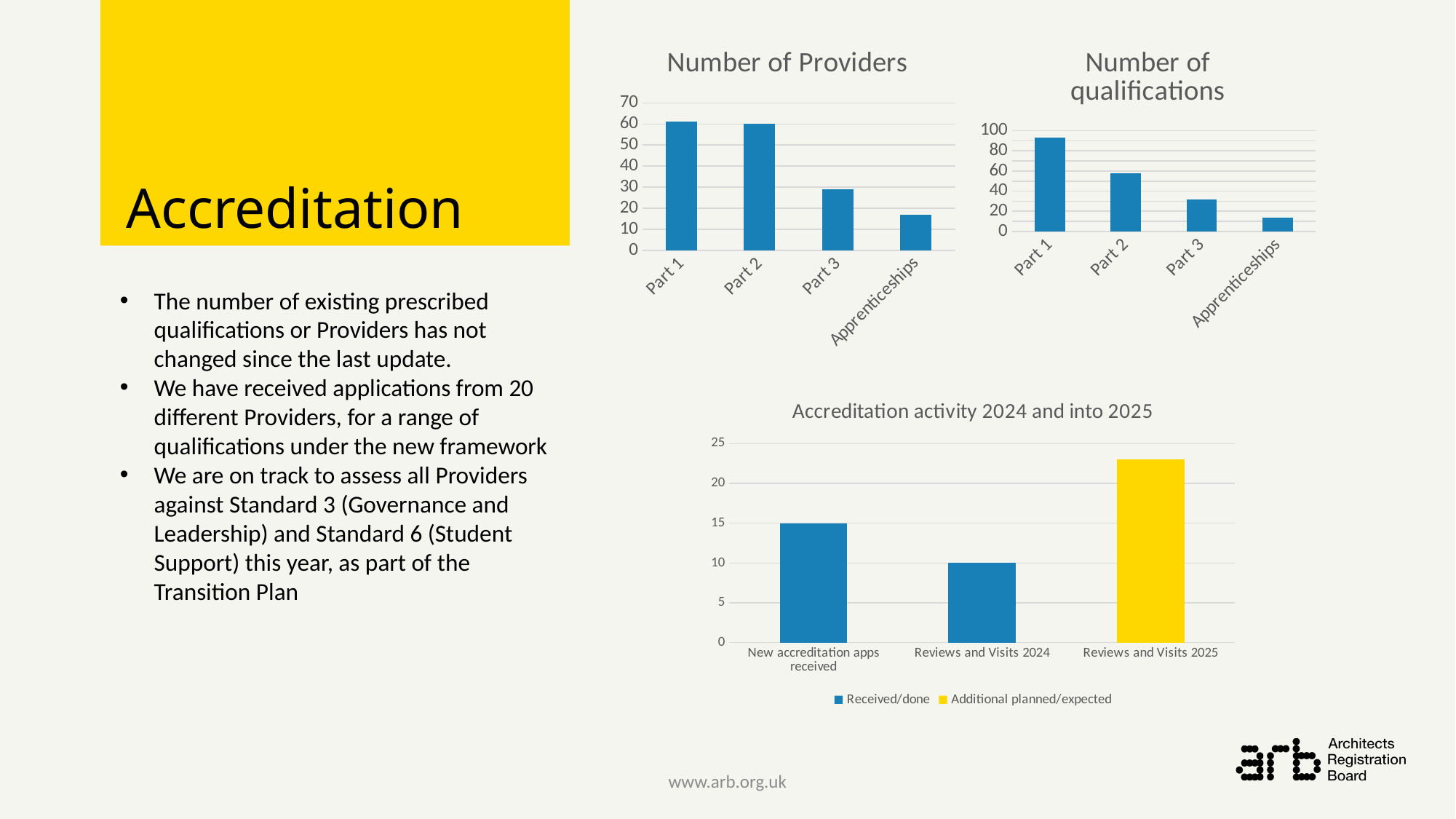
In the 'Number of qualifications' chart, which category has the lowest value? Apprenticeships In the 'Number of qualifications' chart, is the value for Part 1 greater or less than 80? greater How many series does the legend of the 'Accreditation activity 2024 and into 2025' chart list? 2 In the 'Accreditation activity 2024 and into 2025' chart, what is the value for 'New accreditation apps received'? 15 How many categories are shown in the 'Number of Providers' chart? 4 In the 'Number of Providers' chart, is the value for Part 3 greater or less than 20? greater In the 'Accreditation activity 2024 and into 2025' chart, what is the value for 'Reviews and Visits 2024'? 10 In the 'Number of Providers' chart, is the value for Apprenticeships greater or less than 20? less In the 'Number of Providers' chart, which category has the lowest value? Apprenticeships In the 'Number of qualifications' chart, which is larger, Part 2 or Part 3? Part 2 In the 'Number of qualifications' chart, which category has the highest value? Part 1 In the 'Accreditation activity 2024 and into 2025' chart, which category has the highest value? Reviews and Visits 2025